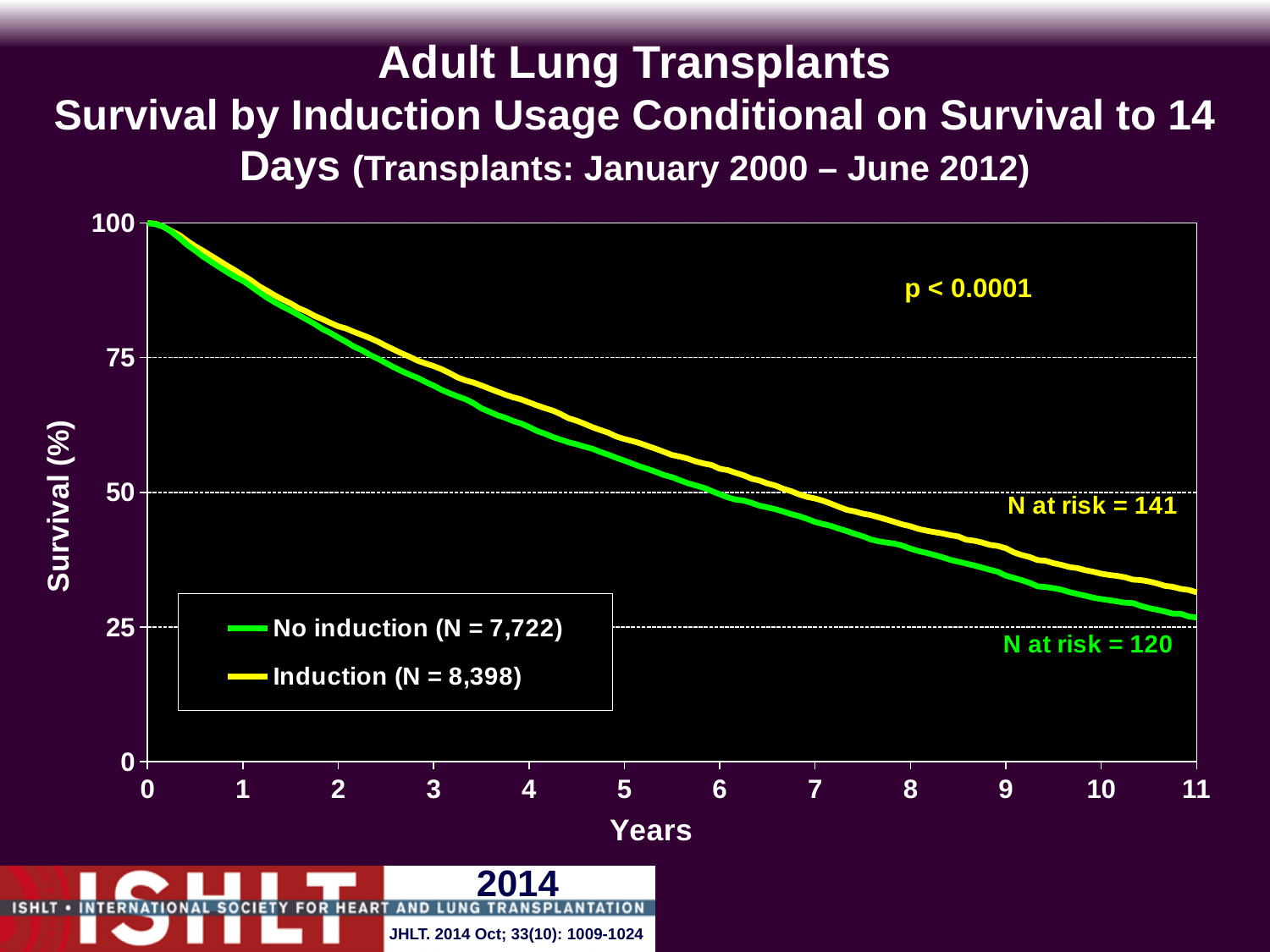
What p-value is printed on the chart? p < 0.0001 How many series does the legend list? 2 Do the survival curves rise or fall as years increase? fall What is the N at risk printed next to the No induction (green) curve? 120 At 11 years, which group has higher survival, Induction or No induction? Induction Is the survival value for the Induction group at 8 years greater or less than 50? less Is the survival value for the No induction group at 1 year greater or less than 75? greater What is the N for the No induction group shown in the legend? 7,722 What is the N at risk printed next to the Induction (yellow) curve? 141 What is the N for the Induction group shown in the legend? 8,398 What is the label of the y axis? Survival (%) What kind of chart is shown on the slide? line chart